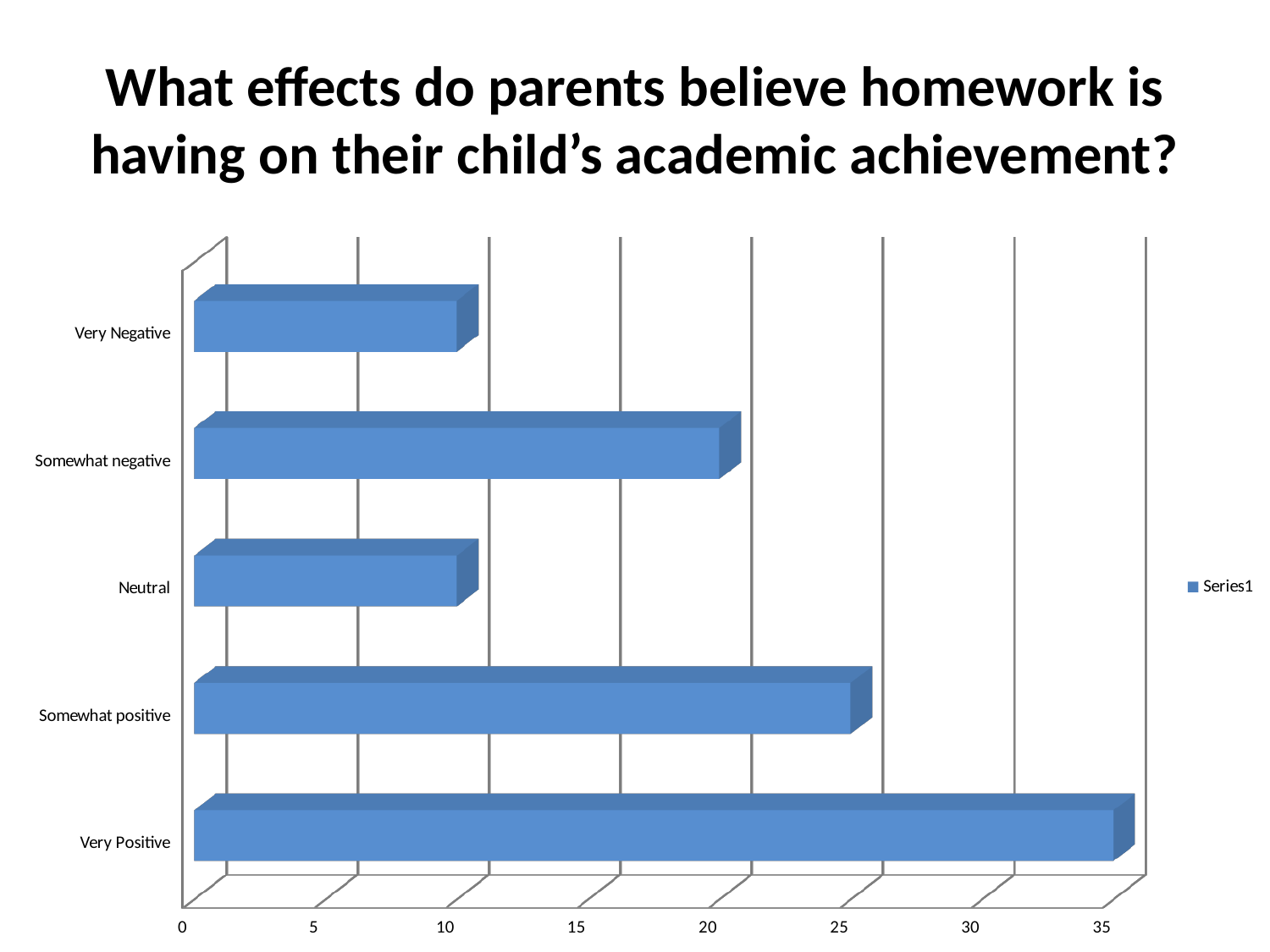
Is the value for Somewhat negative greater or less than 15? greater How many categories are shown on the chart? 5 Is the value for Very Negative greater or less than 15? less What kind of chart is shown on the slide? bar chart Is the value for Neutral greater or less than 15? less Which category has the highest value? Very Positive What is the name of the series shown in the legend? Series1 Which is larger, the value for Very Positive or the value for Very Negative? Very Positive How many series does the legend list? 1 Which is larger, the value for Somewhat positive or the value for Somewhat negative? Somewhat positive